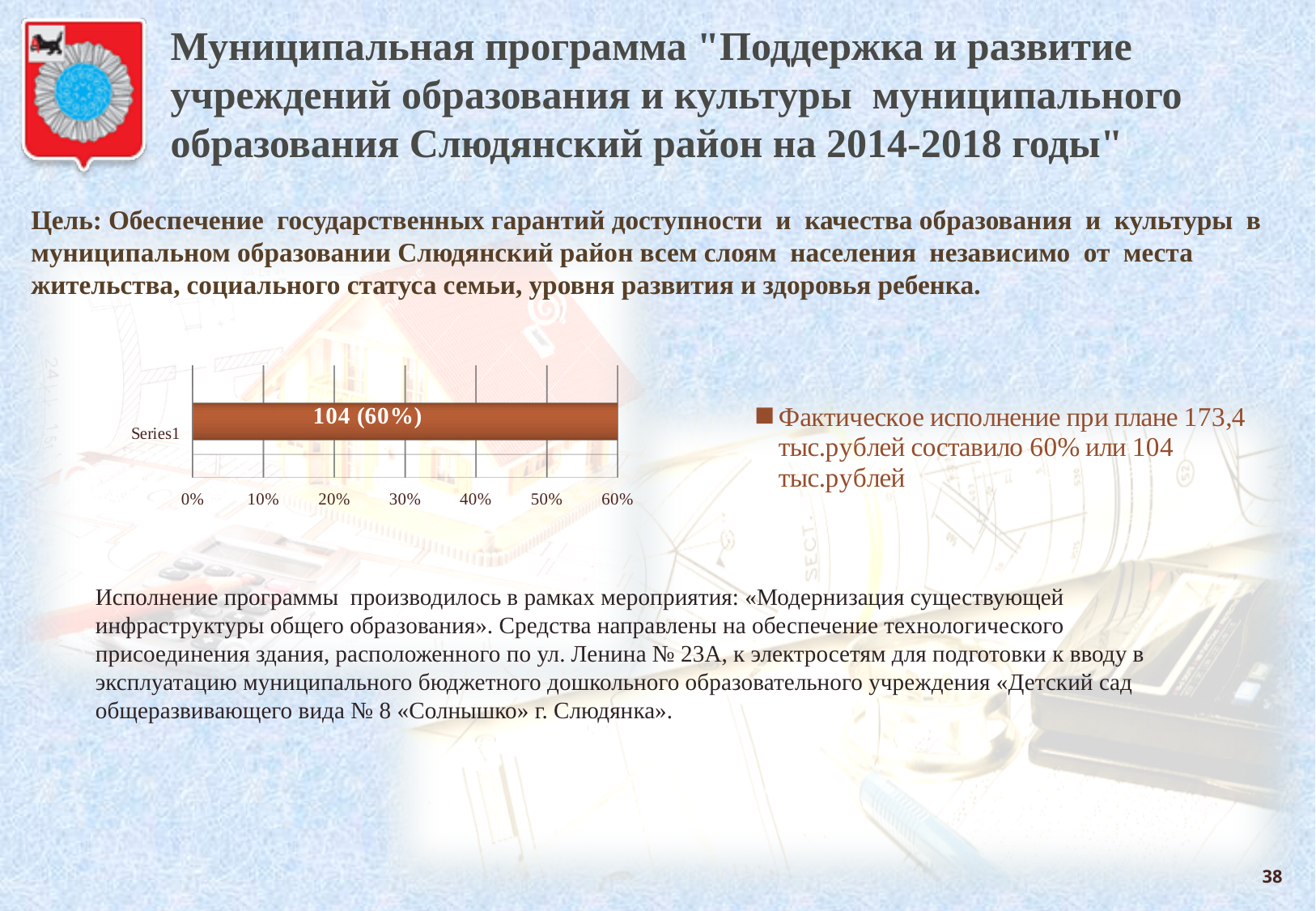
What kind of chart is shown on the slide? bar chart What percentage does the bar for Series1 reach? 60% How many entries does the chart legend list? 1 According to the legend, what was the planned amount in thousand rubles? 173,4 Is the value for Series1 greater or less than 30%? greater What is the category label shown on the y axis of the chart? Series1 Is the value for Series1 greater or less than 50%? greater What is the data label printed on the bar in the chart? 104 (60%) What is the highest value shown on the x axis of the chart? 60% How many bars are plotted in the chart? 1